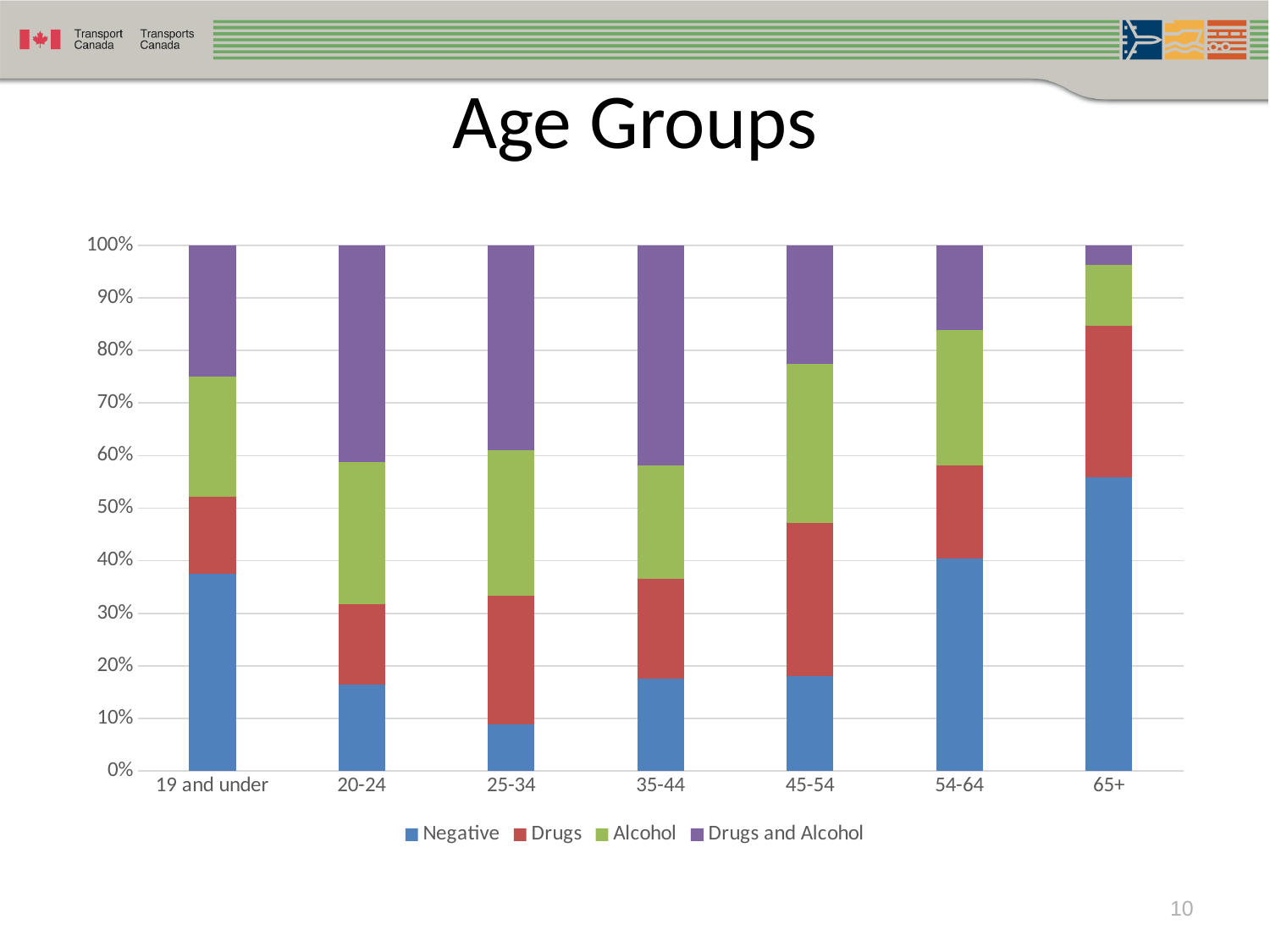
Which age group has the smallest Drugs and Alcohol share? 65+ How many age groups are shown on the x axis? 7 Is the Negative share for 65+ greater or less than 50%? greater How many series does the legend list? 4 What kind of chart is shown on the slide? Stacked bar chart Which age group has the smallest Negative share? 25-34 Is the Negative share for 25-34 greater or less than 10%? less What is the title of the chart? Age Groups Which has the larger Negative share, 54-64 or 45-54? 54-64 Which has the larger Negative share, 19 and under or 20-24? 19 and under Is the Negative share for 20-24 greater or less than 20%? less Which age group has the largest Negative share? 65+